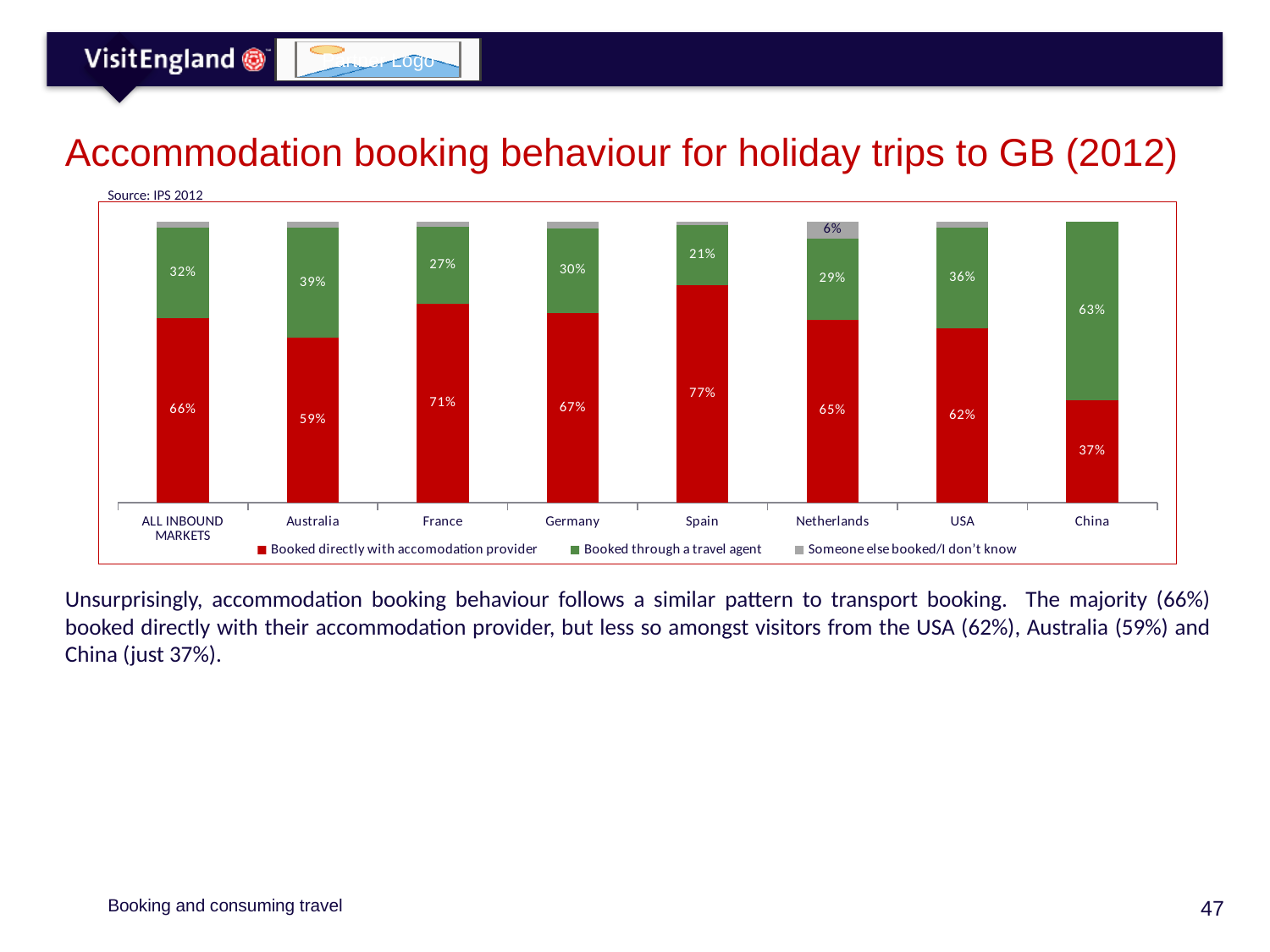
Which is larger: the 'Booked through a travel agent' value for the USA or for Germany? USA How many markets are shown on the x axis of the chart? 8 What is the value for 'Booked directly with accomodation provider' for ALL INBOUND MARKETS? 66% How many series does the chart legend list? 3 What is the difference between the 'Booked directly with accomodation provider' values for France and Australia? 12% Which market has the lowest share of visitors who booked directly with their accommodation provider? China What type of chart is shown on the slide? Stacked bar chart What percentage of visitors from the Netherlands fall under 'Someone else booked/I don't know'? 6% Which colour represents 'Booked through a travel agent' in the chart? Green What percentage of visitors from China booked through a travel agent? 63% Which market has the highest share of visitors who booked directly with their accommodation provider? Spain What percentage of visitors from Spain booked directly with their accommodation provider? 77%